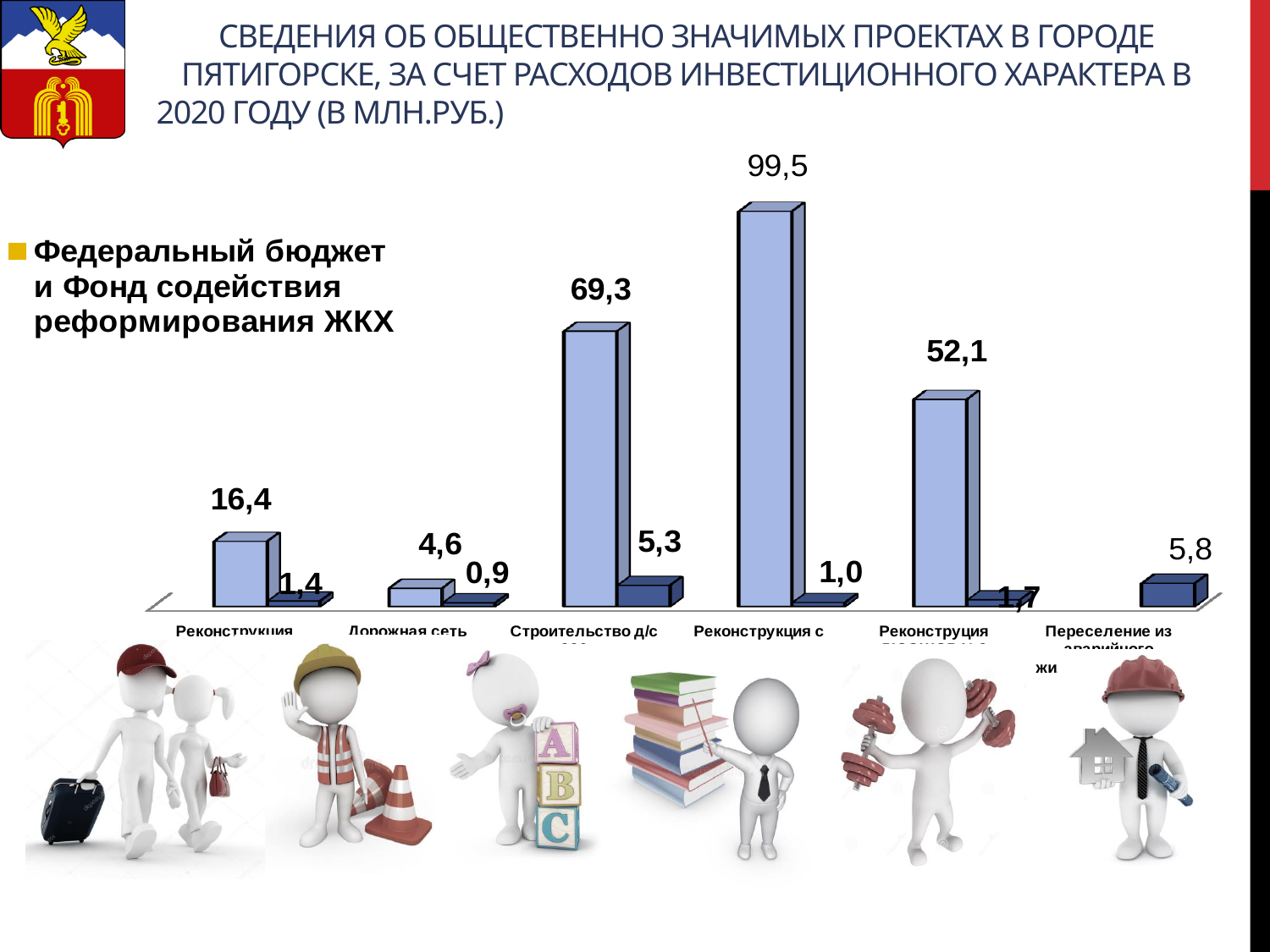
What is the difference between the highest light blue bar (99,5) and the light blue bar for Строительство д/с? 30,2 What is the lowest value labelled on the chart? 0,9 What is the difference between the light blue and dark blue bars for Строительство д/с? 64,0 Which has the larger light blue bar: Дорожная сеть or Строительство д/с? Строительство д/с What is the highest value labelled on the chart? 99,5 How many categories are shown along the x axis of the chart? 6 What is the value of the light blue bar for Строительство д/с? 69,3 What kind of chart is shown on the slide? bar chart What is the value of the dark blue bar for Дорожная сеть? 0,9 What is the value of the dark blue bar for Строительство д/с? 5,3